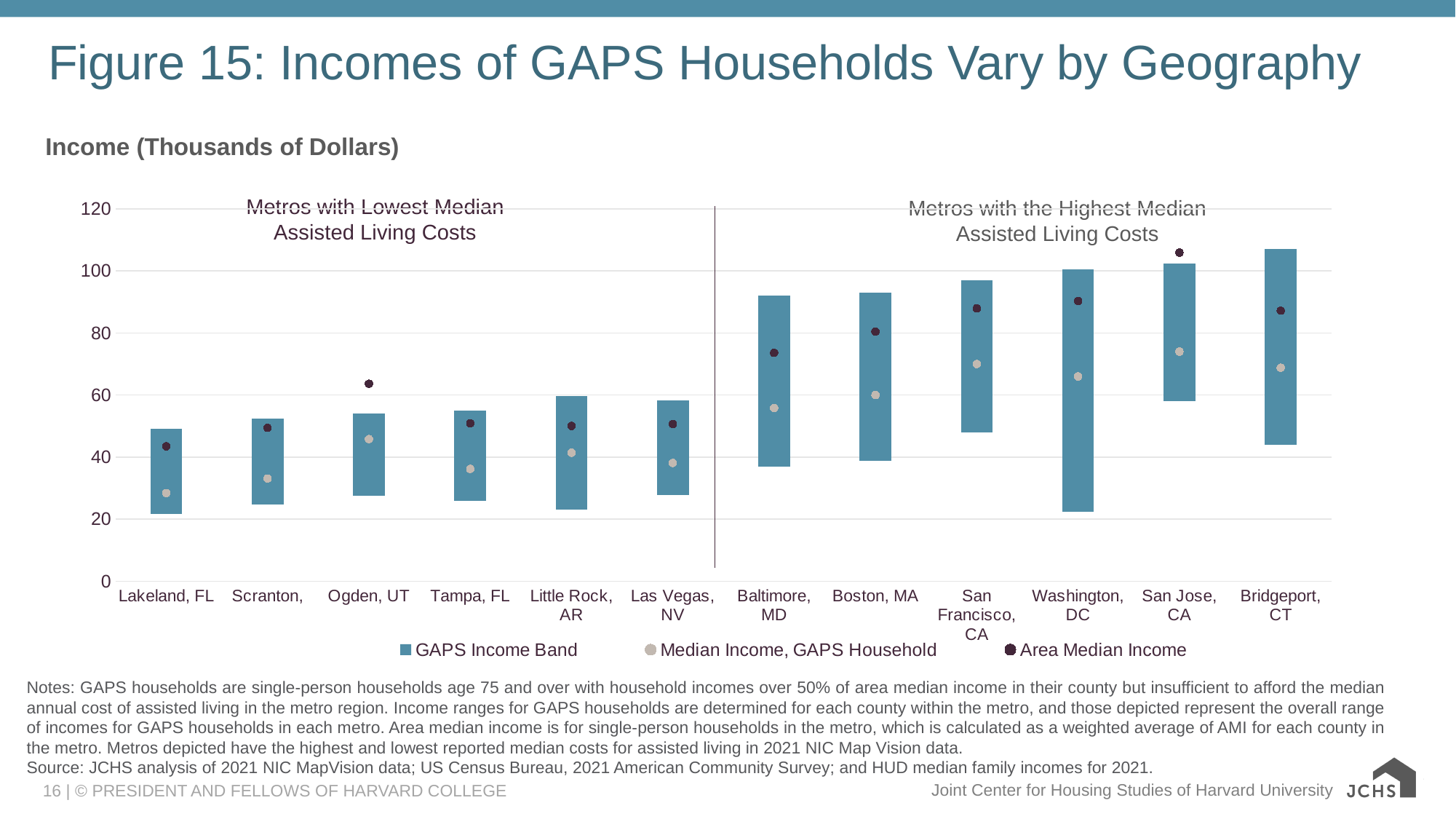
Is the Median Income, GAPS Household for Lakeland, FL greater or less than 40? less What are the two group headings shown above the chart? Metros with Lowest Median Assisted Living Costs; Metros with the Highest Median Assisted Living Costs Is the Area Median Income for Ogden, UT greater or less than 60? greater Which has the higher Area Median Income, Boston, MA or Baltimore, MD? Boston, MA Is the Area Median Income for Washington, DC greater or less than 80? greater What unit is the y axis of the chart measured in? Income (Thousands of Dollars) Which metro has the highest Area Median Income? San Jose, CA Which metro has the lowest Median Income, GAPS Household? Lakeland, FL What kind of chart is used to show the GAPS Income Band? Bar chart How many series does the chart's legend list? 3 How many metro areas are shown on the x axis of the chart? 12